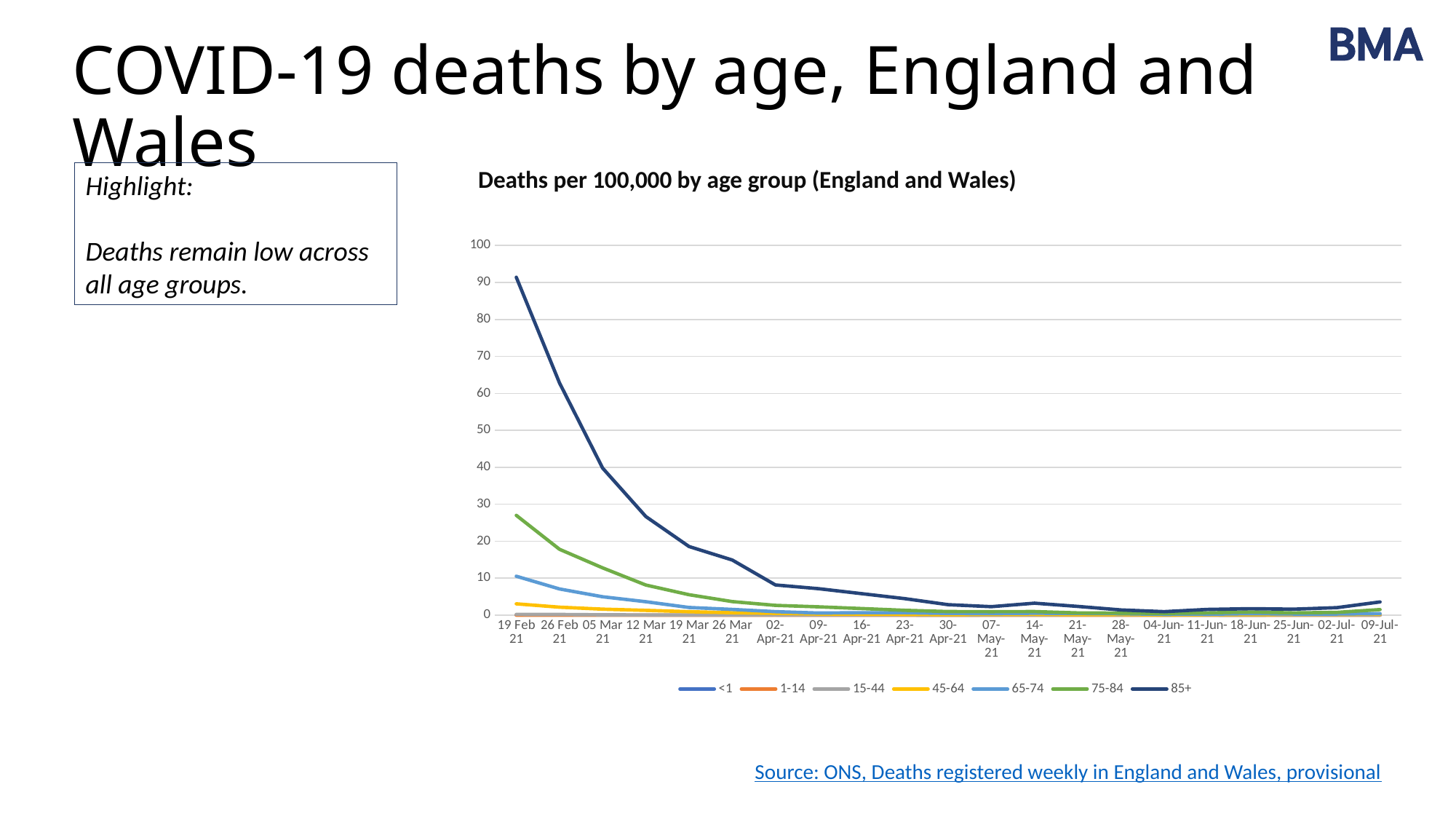
What is the title of the chart? Deaths per 100,000 by age group (England and Wales) How many series does the legend list? 7 Does the 85+ line rise or fall between 19 Feb 21 and 02-Apr-21? fall Is the value for the 85+ age group on 12 Mar 21 greater or less than 20? greater What is the last date shown on the x axis? 09-Jul-21 What kind of chart is shown on the slide? line chart Is the value for the 85+ age group on 19 Feb 21 greater or less than 80? greater Which age group has the highest deaths per 100,000 on 19 Feb 21? 85+ Which is larger on 19 Feb 21, the value for 85+ or the value for 75-84? 85+ Is the value for the 65-74 age group on 19 Feb 21 greater or less than 20? less How many dates are shown along the x axis? 21